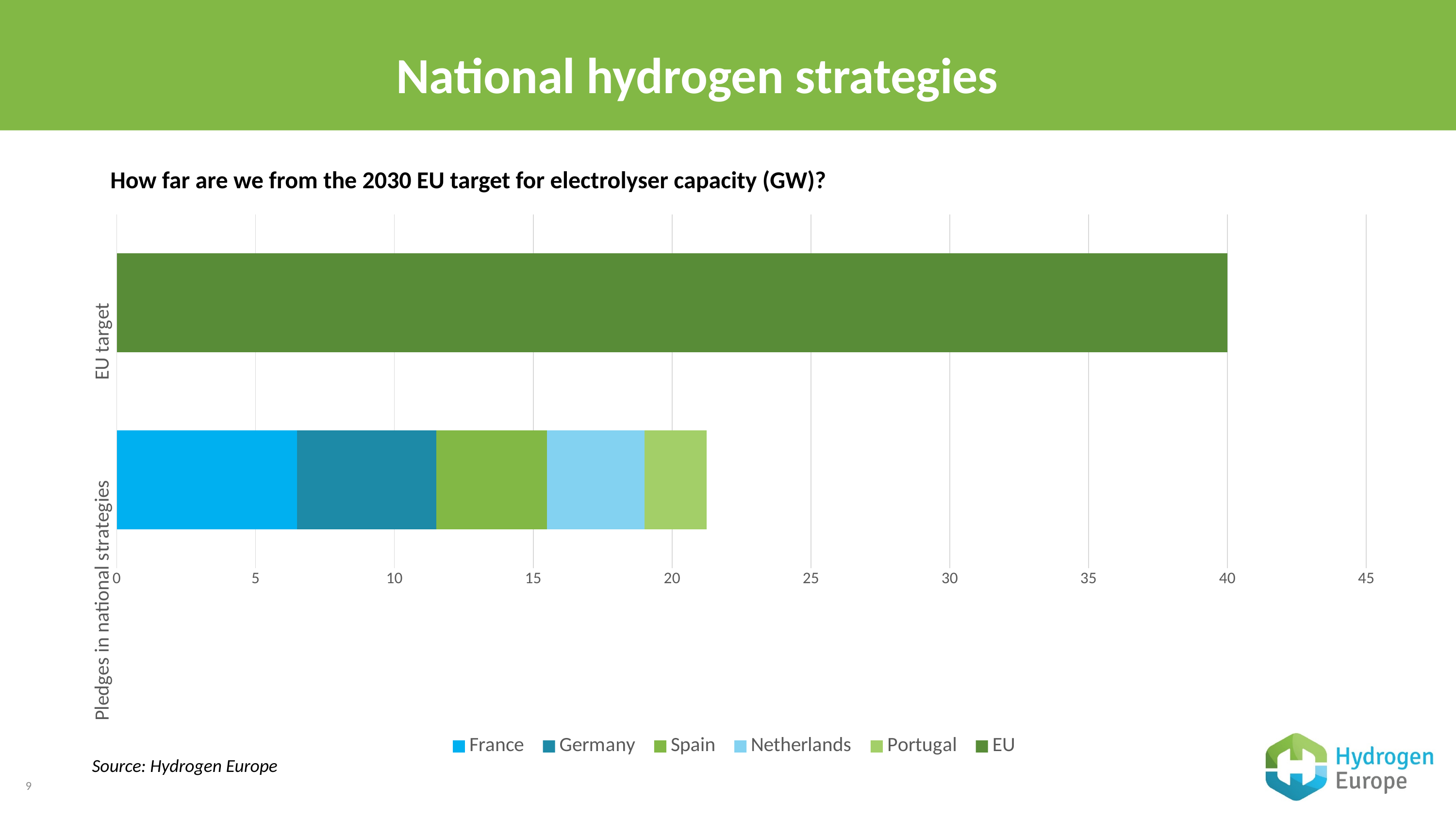
Which country contributes the largest segment to the 'Pledges in national strategies' bar? France Is the total of the 'Pledges in national strategies' bar greater or less than 25? less Which category has the highest value? EU target How many categories are shown on the vertical axis? 2 How many series does the legend list? 6 What is the value of the EU target bar (GW)? 40 What kind of chart is shown on the slide? Bar chart Which bar is longer: 'EU target' or 'Pledges in national strategies'? EU target In the 'Pledges in national strategies' bar, which segment is larger: France or Portugal? France What is the title of the chart? How far are we from the 2030 EU target for electrolyser capacity (GW)? Is the France segment of the 'Pledges in national strategies' bar greater or less than 5? greater Is the total of the 'Pledges in national strategies' bar greater or less than 20? greater